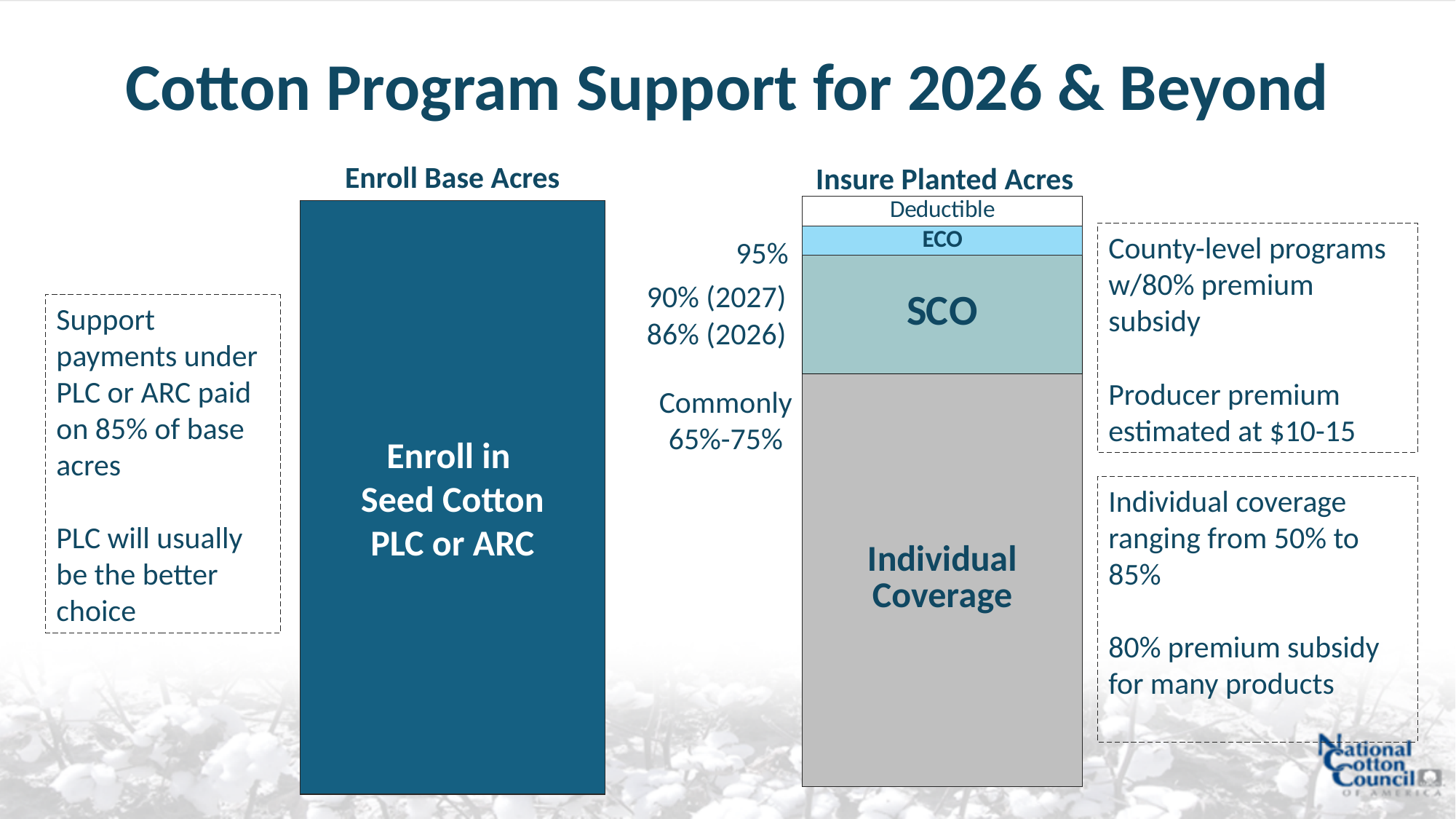
In the Insure Planted Acres diagram, how many layers make up the stacked bar? 4 In the Insure Planted Acres diagram, which layer is larger, SCO or ECO? SCO In the Insure Planted Acres diagram, which layer sits at the very top of the bar? Deductible In the Insure Planted Acres diagram, what range is labeled as the common level for Individual Coverage? 65%-75% In the Insure Planted Acres diagram, what coverage level is labeled at the top of the SCO layer (boundary with ECO)? 95% In the Insure Planted Acres diagram, which layer occupies the largest portion of the bar? Individual Coverage In the Insure Planted Acres diagram, which layer is directly below ECO? SCO In the Insure Planted Acres diagram, what coverage level is shown for SCO in 2026? 86% (2026) In the Insure Planted Acres diagram, what coverage level is shown for SCO in 2027? 90% (2027) What is the label inside the large dark blue bar under Enroll Base Acres? Enroll in Seed Cotton PLC or ARC